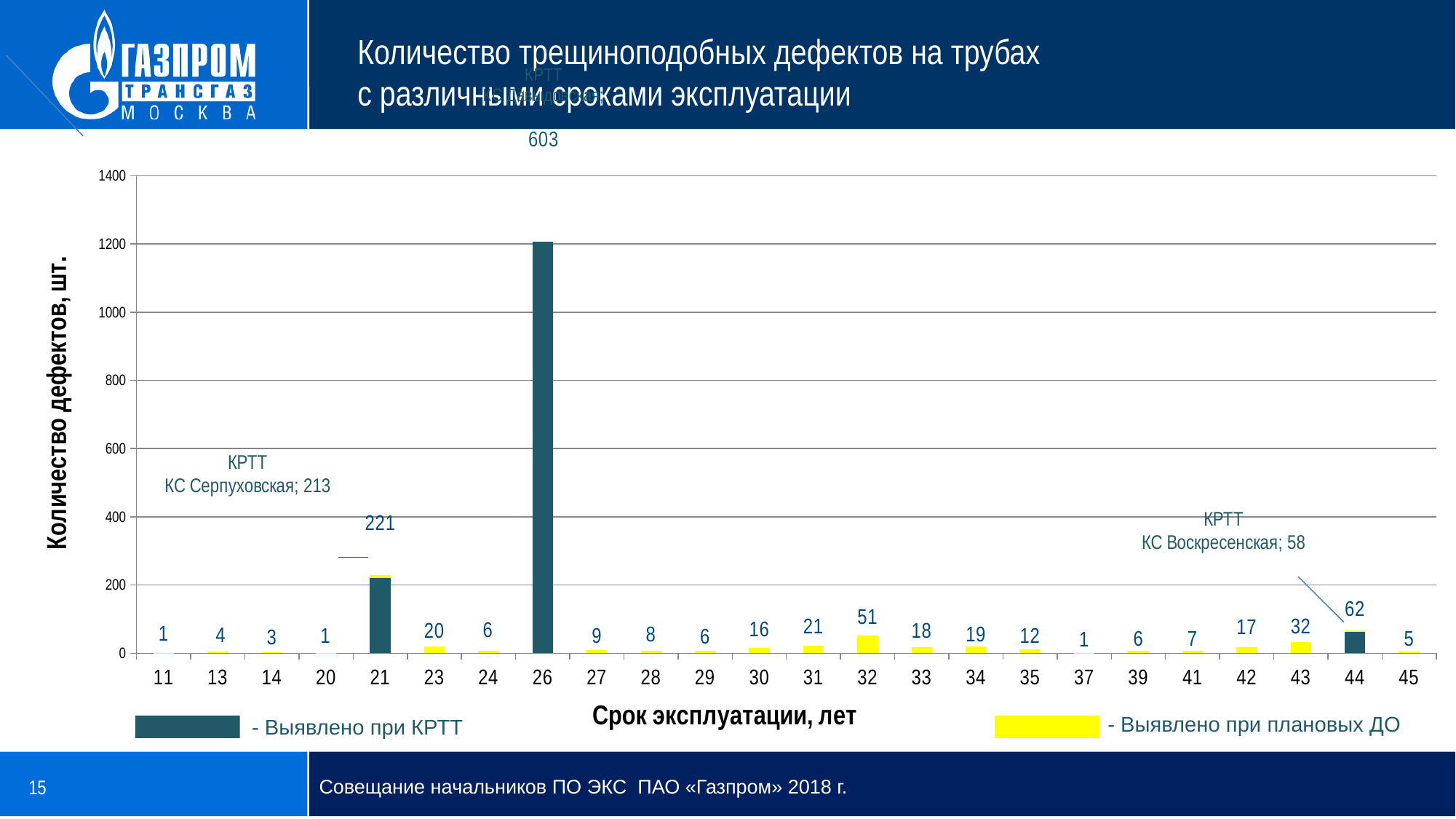
What is the labelled value for 32 years? 51 Which has the larger labelled value, 32 years or 33 years? 32 years What kind of chart is shown on the slide? bar chart What is the difference between the labelled values for 32 years and 43 years? 19 Is the value of the bar for 21 years greater or less than 200? greater Is the value of the bar for 26 years greater or less than 1000? greater How many operating-life categories are shown on the x axis? 24 What is the title of the y axis? Количество дефектов, шт. What is the labelled value for 30 years? 16 Which operating life (years) has the tallest bar on the chart? 26 How many series does the legend list? 2 What is the labelled value for 43 years? 32